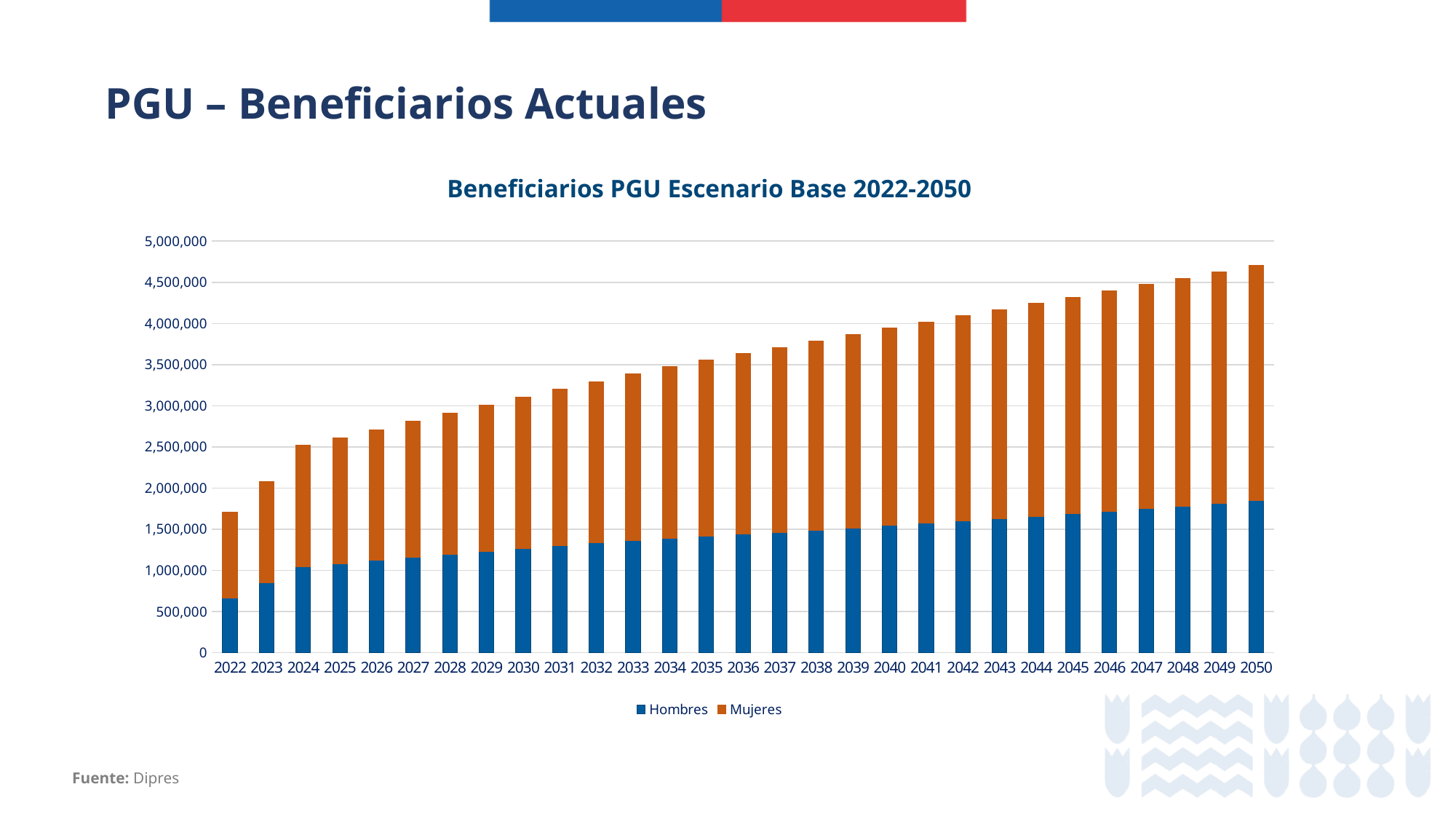
Which year has the lowest total number of beneficiaries? 2022 How many years are shown along the x axis? 29 Which year has the highest total number of beneficiaries? 2050 Do the total beneficiaries rise or fall from 2022 to 2050? Rise What is the title of the chart? Beneficiarios PGU Escenario Base 2022-2050 How many series does the legend list? 2 Is the total value for 2022 greater or less than 2,000,000? less Is the total value for 2030 greater or less than 3,000,000? greater Is the Hombres value for 2022 greater or less than 500,000? greater In 2050, which series is larger, Hombres or Mujeres? Mujeres What kind of chart is shown on the slide? Stacked bar chart